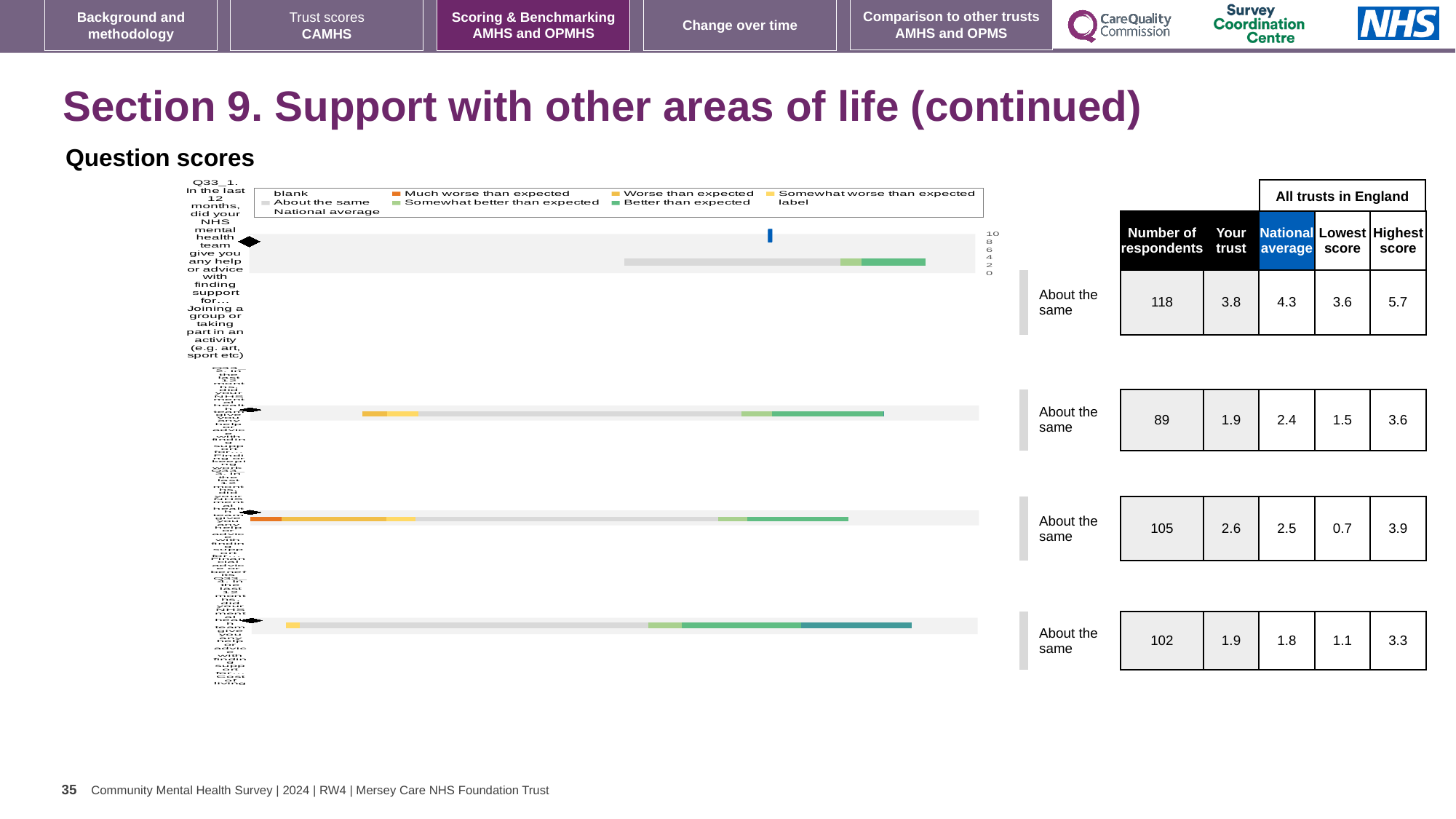
In the table beside the chart, what is the national average for the first (top) bar, Q33_1? 4.3 How many horizontal bars (question rows) are plotted in the chart? 4 Which bar row has the lowest number of respondents in the table beside the chart? The second bar (89 respondents) In the table beside the chart, what is the number of respondents for the first (top) bar, Q33_1? 118 For the first (top) bar, Q33_1, which is larger: the 'Your trust' score or the national average? National average What kind of chart is shown on the slide? bar chart Which legend entry is shown in grey in the chart's legend? About the same What is the question code shown at the start of the first (top) bar's label? Q33_1 In the table beside the chart, what is the 'Your trust' score for the first (top) bar, Q33_1? 3.8 How many entries does the chart's legend list? 9 For the first (top) bar, Q33_1, what is the difference between the national average (4.3) and the 'Your trust' score (3.8)? 0.5 In the table beside the chart, what is the highest score for the fourth (bottom) bar? 3.3